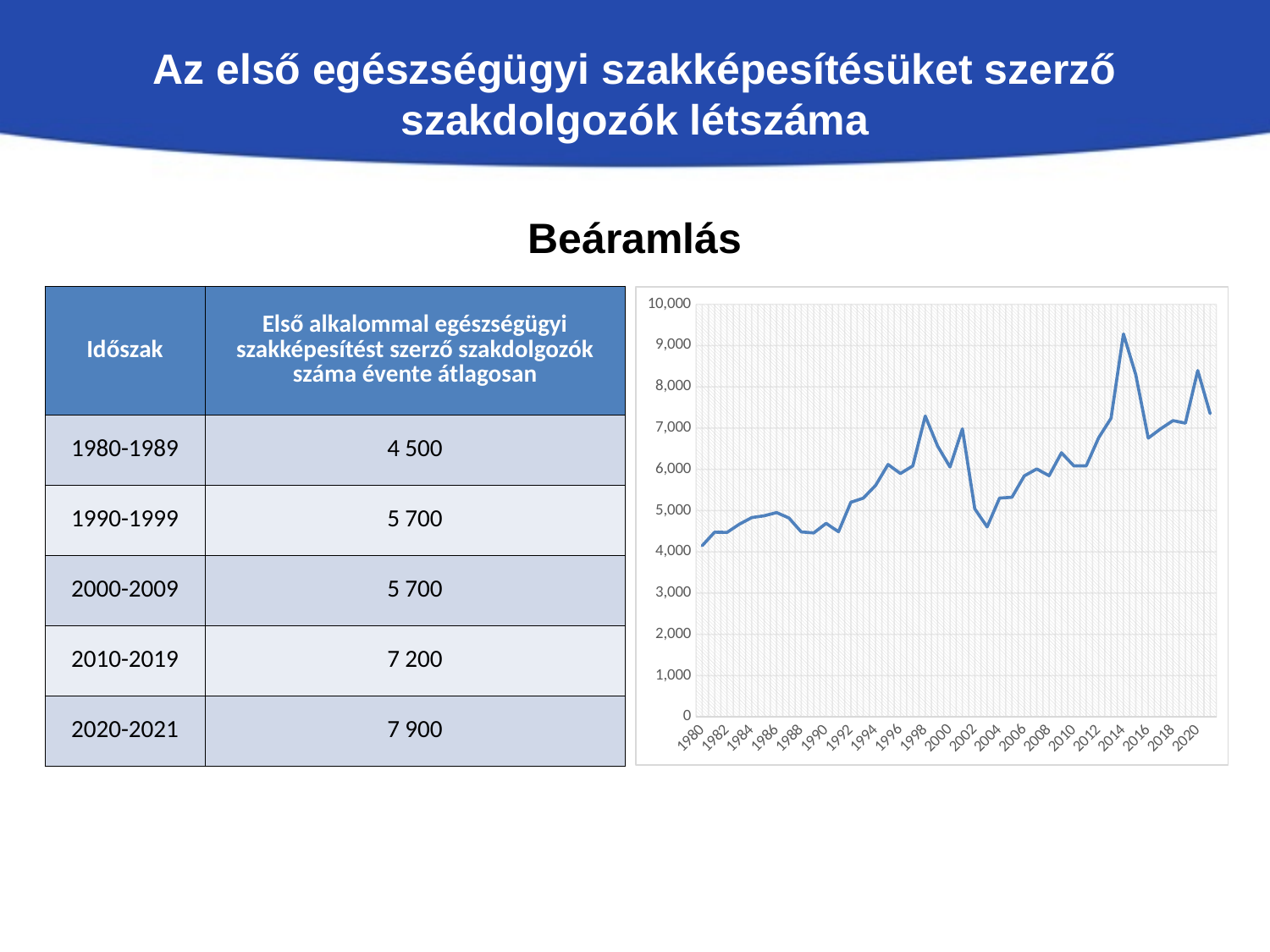
In which year does the line chart show its lowest value? 1980 Is the value for 1980 on the line chart greater or less than 5,000? less Is the value for 2004 on the line chart greater or less than 5,000? greater Overall, do the values on the line chart rise or fall from 1980 to 2021? rise What kind of chart is shown on the slide? line chart In which year does the line chart reach its highest value? 2014 How many lines are plotted on the chart? 1 Is the peak value around 2015 on the line chart greater or less than 8,000? greater Which year has the larger value on the line chart, 1980 or 2020? 2020 What is the highest tick value shown on the vertical axis of the line chart? 10,000